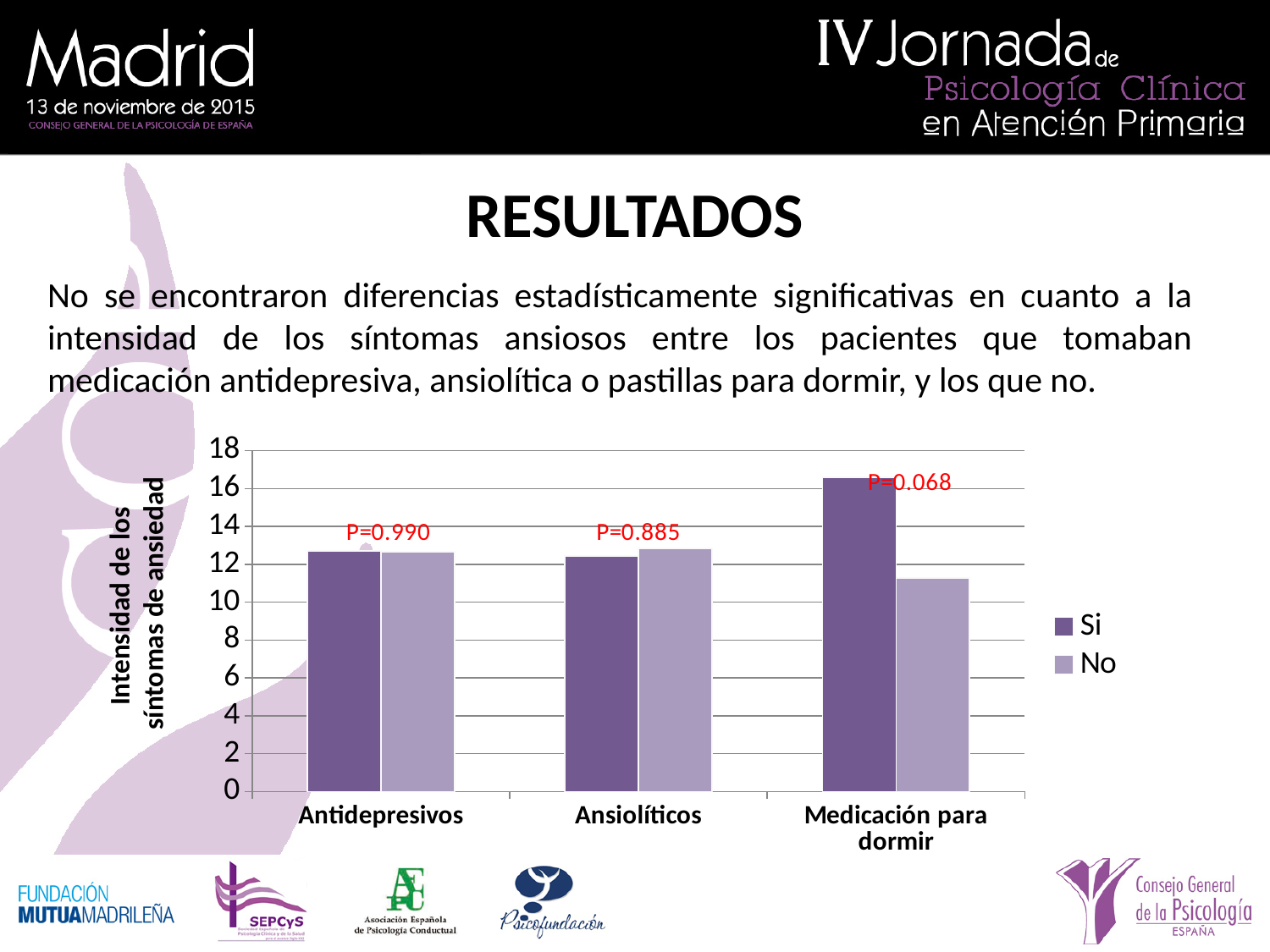
Which bar is the lowest in the chart? No for Medicación para dormir Is the value for No in Ansiolíticos greater or less than 14? less Which category has the highest bar in the chart? Medicación para dormir What P-value is printed above the Antidepresivos bars? P=0.990 What kind of chart is shown on the slide? bar chart How many categories are shown on the x axis of the chart? 3 For Medicación para dormir, which series has the larger value, Si or No? Si How many series does the chart legend list? 2 Is the value for Si in Antidepresivos greater or less than 12? greater Is the value for Si in Medicación para dormir greater or less than 14? greater What is the title of the y axis of the chart? Intensidad de los síntomas de ansiedad